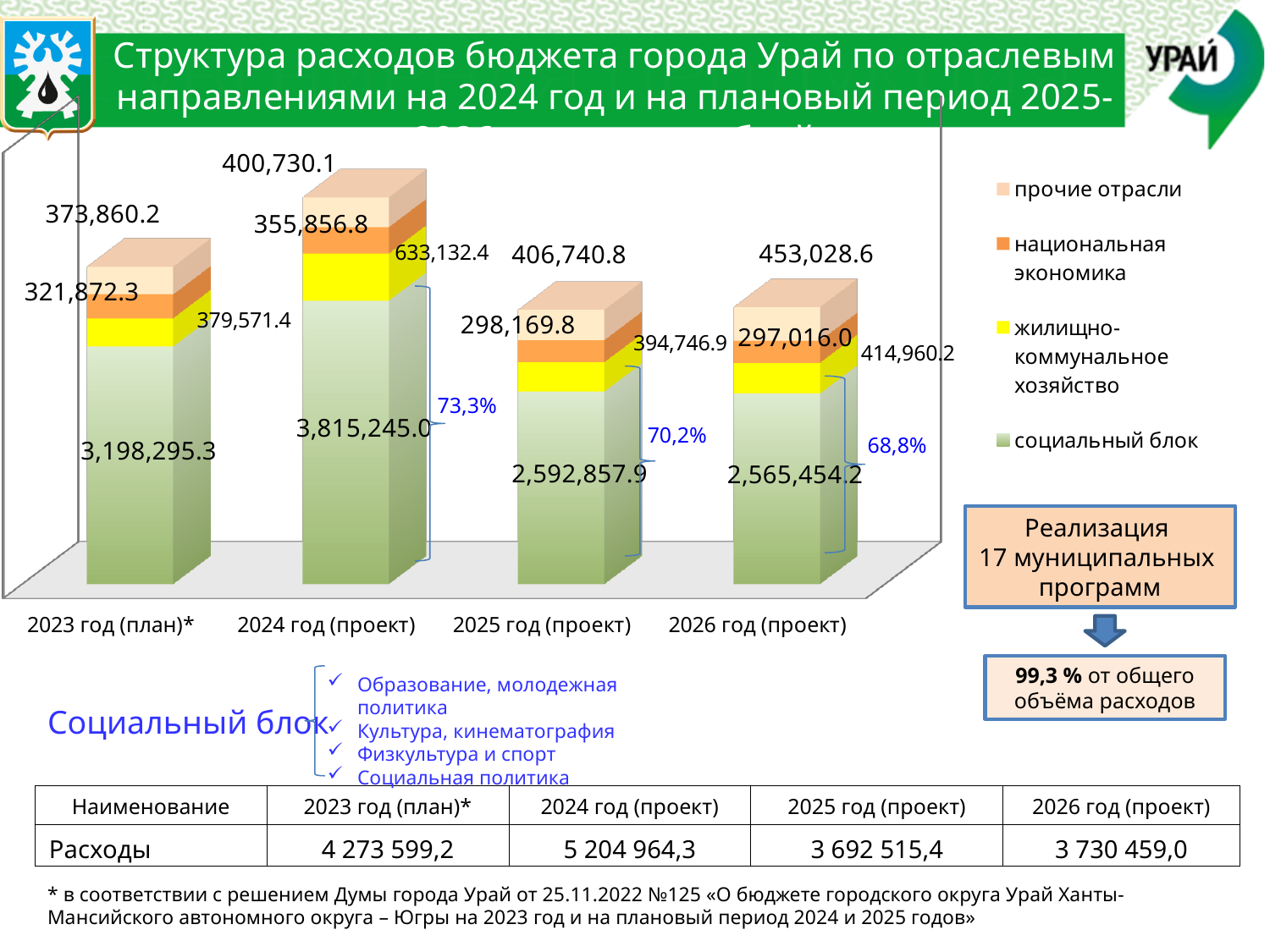
How many series does the chart legend list? 4 Which is larger: the прочие отрасли value for 2025 год (проект) or for 2026 год (проект)? 2026 год (проект) What is the difference between the социальный блок values for 2024 год (проект) and 2023 год (план)*? 616,949.7 What is the value of the социальный блок segment for 2024 год (проект)? 3,815,245.0 Does the социальный блок value rise or fall from 2024 год (проект) to 2026 год (проект)? Fall What kind of chart is shown on the slide? Stacked bar chart In which year is the социальный блок segment the smallest? 2026 год (проект) What is the value of the прочие отрасли segment for 2026 год (проект)? 453,028.6 How many years (categories) are shown on the x axis of the chart? 4 What is the value of the национальная экономика segment for 2025 год (проект)? 298,169.8 What is the value of the жилищно-коммунальное хозяйство segment for 2023 год (план)*? 379,571.4 In which year is the социальный блок segment the largest? 2024 год (проект)